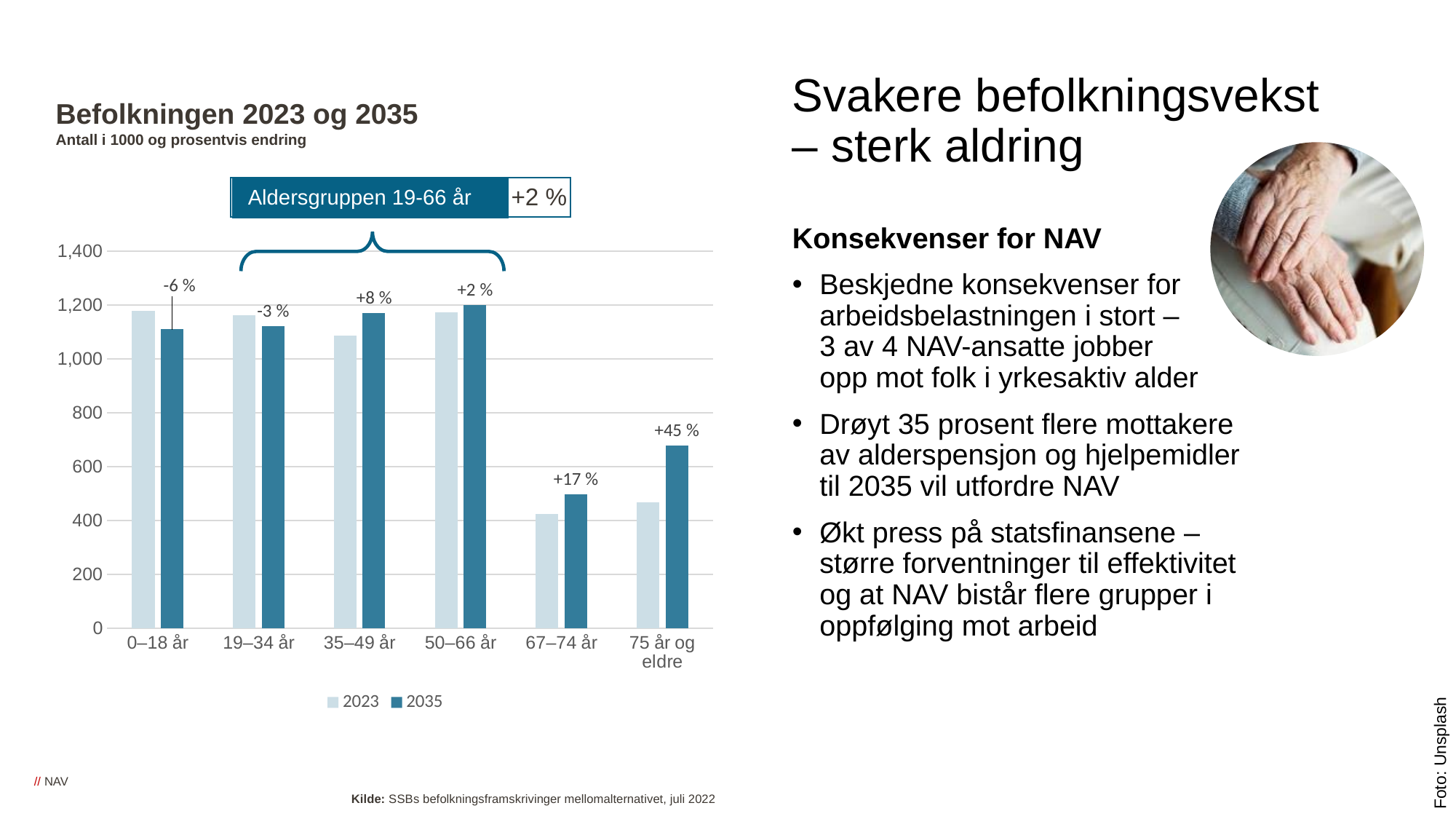
What is the title of the chart? Befolkningen 2023 og 2035 How many age groups are shown on the x axis of the chart? 6 What percentage change is labelled for the age group 0–18 år? -6 % Which is larger for the age group 50–66 år, the 2023 value or the 2035 value? 2035 What percentage change is labelled for the age group 67–74 år? +17 % What percentage change is labelled for the age group 75 år og eldre? +45 % How many series does the chart legend list? 2 Which age group has the largest labelled percentage change? 75 år og eldre What percentage change is labelled for the age group 35–49 år? +8 % Which age group has the lowest labelled percentage change? 0–18 år Is the 2035 value for the age group 67–74 år greater or less than 400? greater What type of chart is shown on the slide? bar chart